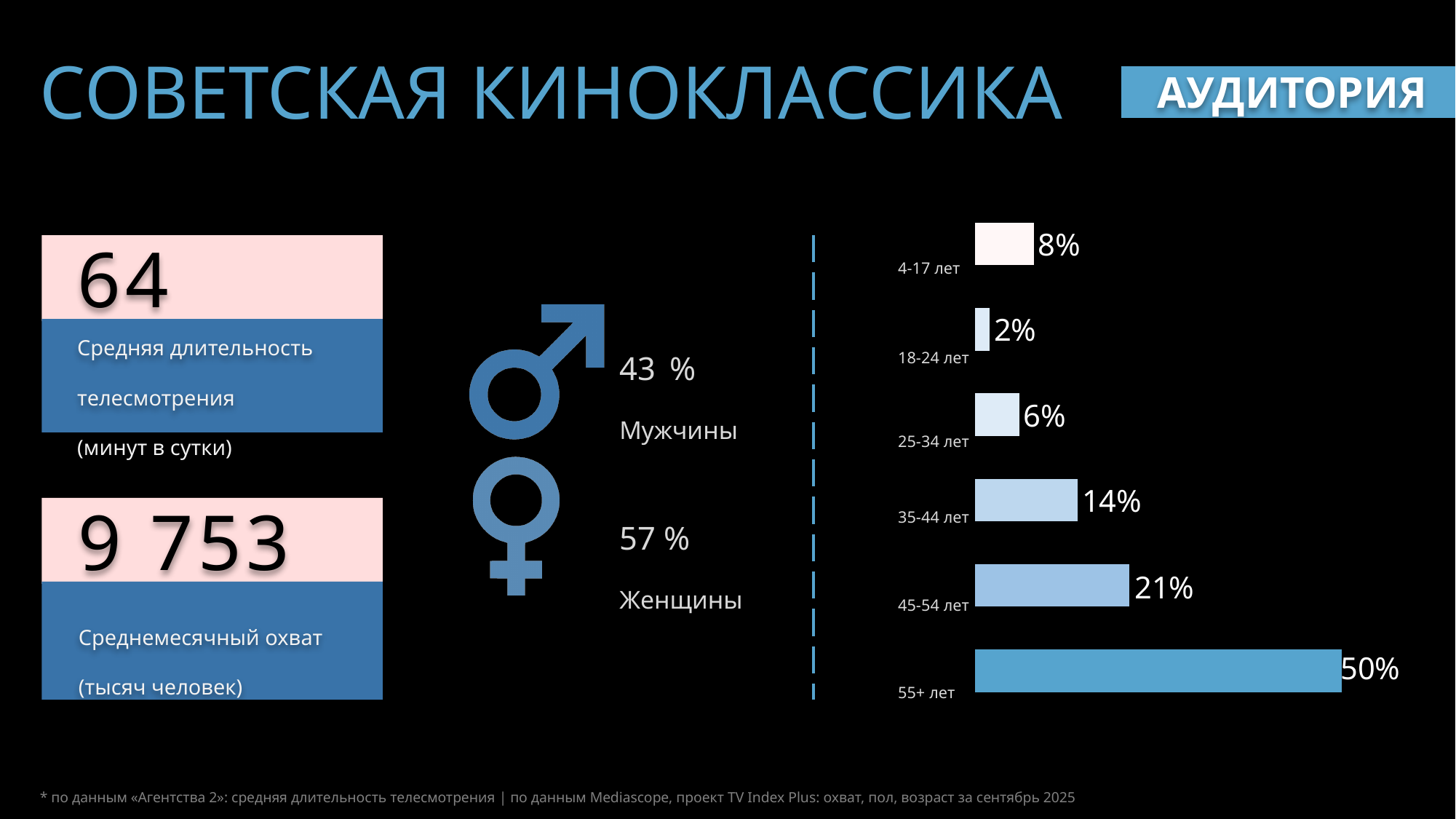
In the age-group bar chart, which age group has the lowest value? 18-24 лет In the age-group bar chart, what is the difference between the values for 55+ лет and 45-54 лет? 29% In the age-group bar chart, which is larger: the value for 4-17 лет or the value for 25-34 лет? 4-17 лет In the age-group bar chart, do the values rise or fall from 25-34 лет down to 55+ лет? rise In the age-group bar chart, what is the value for 35-44 лет? 14% In the age-group bar chart, what is the difference between the values for 35-44 лет and 25-34 лет? 8% In the age-group bar chart, which age group has the highest value? 55+ лет In the age-group bar chart, what is the value for 18-24 лет? 2% In the age-group bar chart, what is the value for 55+ лет? 50% What kind of chart is used to show the age groups? bar chart In the age-group bar chart, what is the value for 4-17 лет? 8% How many age groups are shown in the bar chart? 6